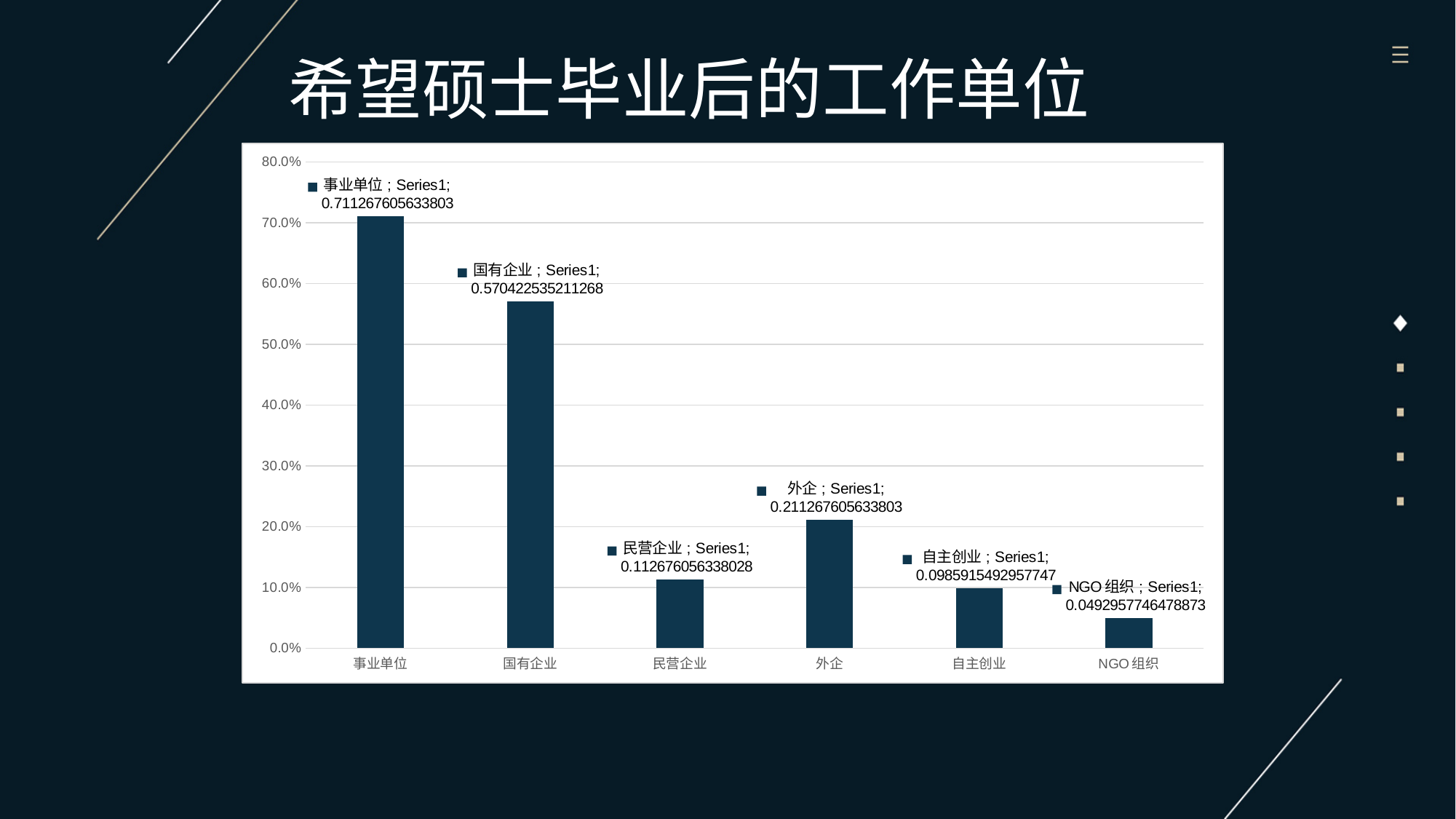
What is the value for 事业单位? 0.711267605633803 What is the title of the slide? 希望硕士毕业后的工作单位 Which category has the lowest value? NGO 组织 What is the value for NGO 组织? 0.0492957746478873 Which category has the highest value? 事业单位 What is the value for 国有企业? 0.570422535211268 What is the difference between the values for 事业单位 and 国有企业? 0.140845070422535 Is the value for 国有企业 greater or less than 60%? less What is the value for 外企? 0.211267605633803 Which is larger, the value for 外企 or the value for 民营企业? 外企 What kind of chart is shown on the slide? bar chart How many categories are shown on the x axis? 6